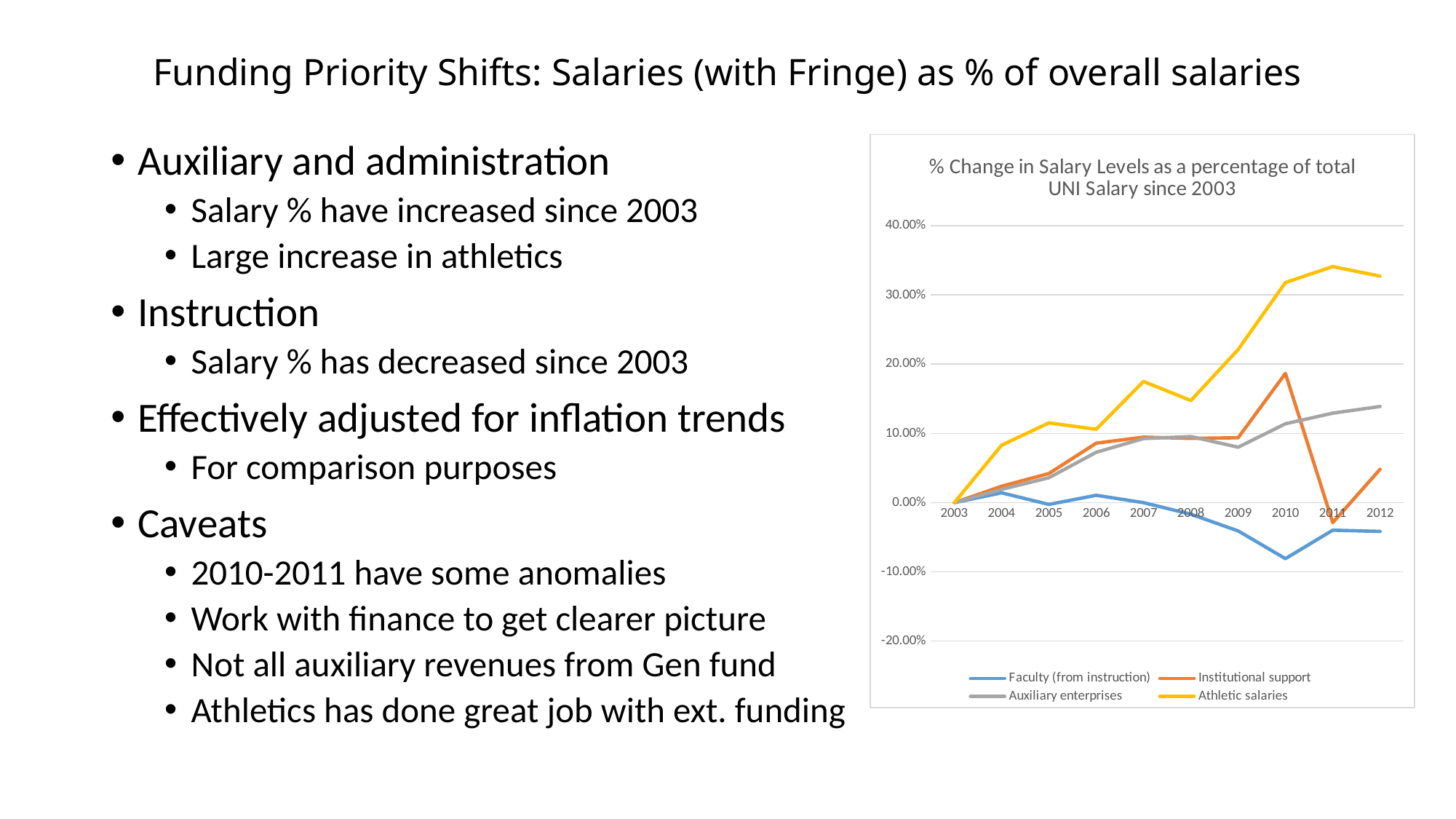
Does the Athletic salaries line generally rise or fall from 2003 to 2012? rise Which series has the highest value in 2012? Athletic salaries Which series has the lowest value in 2012? Faculty (from instruction) What kind of chart is shown on the slide? line chart How many years are plotted along the x axis of the chart? 10 In 2010, which is larger: Institutional support or Auxiliary enterprises? Institutional support Is the value for Athletic salaries in 2011 greater or less than 30.00%? greater What is the title of the chart? % Change in Salary Levels as a percentage of total UNI Salary since 2003 Is the value for Auxiliary enterprises in 2012 greater or less than 10.00%? greater Is the value for Faculty (from instruction) in 2010 greater or less than 0.00%? less What colour is the Athletic salaries line in the chart? yellow How many series does the chart legend list? 4